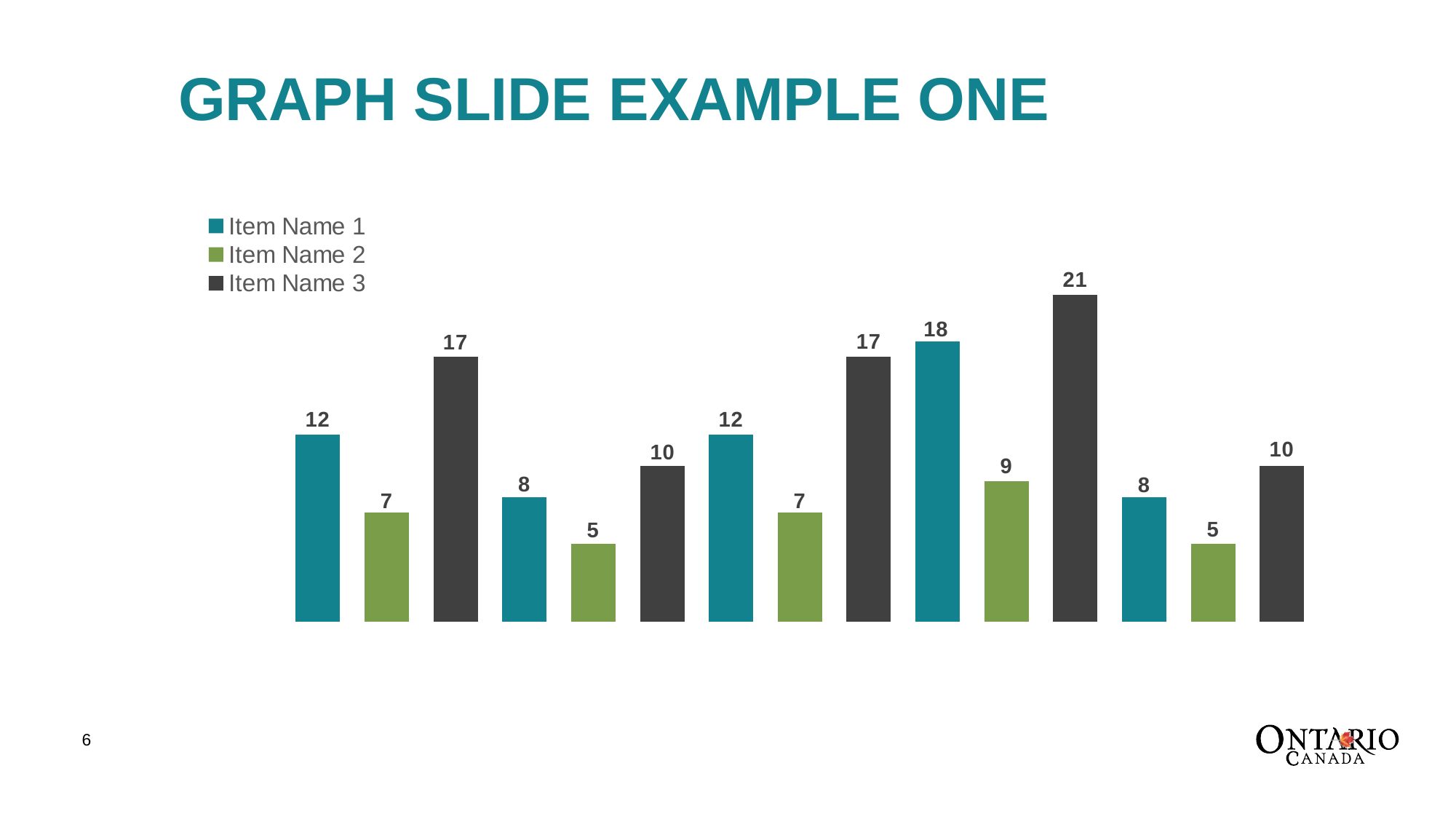
What is the value of Item Name 3 in the second group of bars? 10 What are the three legend entries on the chart? Item Name 1, Item Name 2, Item Name 3 What is the lowest value shown for Item Name 2? 5 What is the value of Item Name 2 in the fourth group of bars? 9 What is the highest value shown for Item Name 3? 21 What kind of chart is shown on the slide? bar chart What is the highest value plotted on the whole chart? 21 How many series does the legend list? 3 In the first group of bars, which is larger: Item Name 1 or Item Name 3? Item Name 3 How many groups of bars are plotted along the x axis? 5 What is the value of Item Name 1 in the first group of bars? 12 In the fourth group of bars, what is the difference between Item Name 3 and Item Name 1? 3